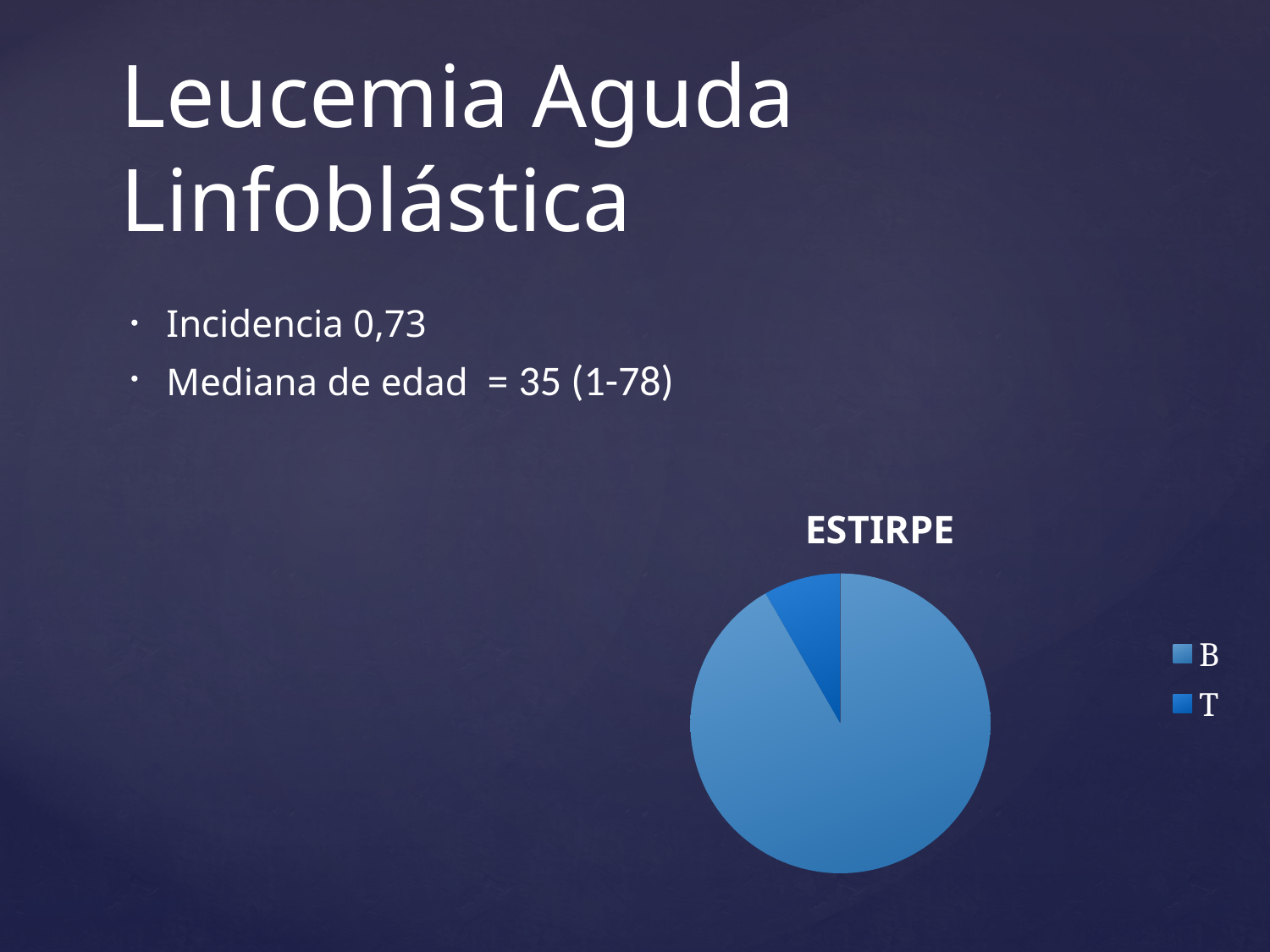
What are the two categories shown in the legend? B and T Which category has the largest slice of the pie? B How many entries does the chart legend list? 2 How many slices does the pie chart have? 2 What kind of chart is shown on the slide? pie chart What is the title of the chart? ESTIRPE Which slice is larger, B or T? B Which category has the smallest slice of the pie? T